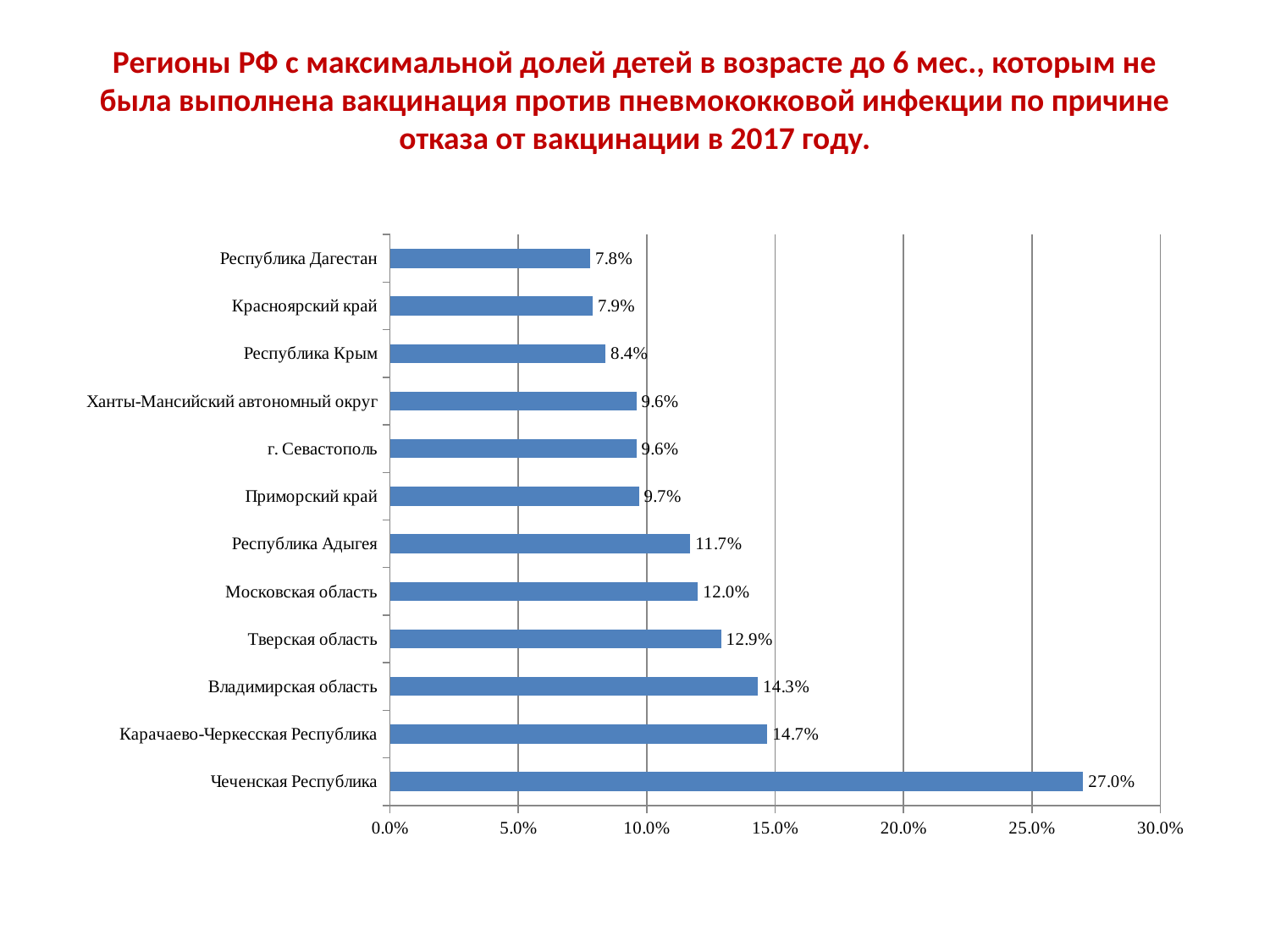
Which is larger, the value for Республика Адыгея or the value for Приморский край? Республика Адыгея How many regions are shown in the chart? 12 Which region has the lowest value? Республика Дагестан What is the difference between the values for Чеченская Республика and Карачаево-Черкесская Республика? 12.3% What is the maximum value shown on the horizontal axis? 30.0% Which region has the highest value? Чеченская Республика What is the value for Московская область? 12.0% What kind of chart is shown on the slide? bar chart What is the value for Республика Крым? 8.4% What is the difference between the values for Владимирская область and Тверская область? 1.4% What is the value for Чеченская Республика? 27.0% Is the value for Карачаево-Черкесская Республика greater or less than 10.0%? greater